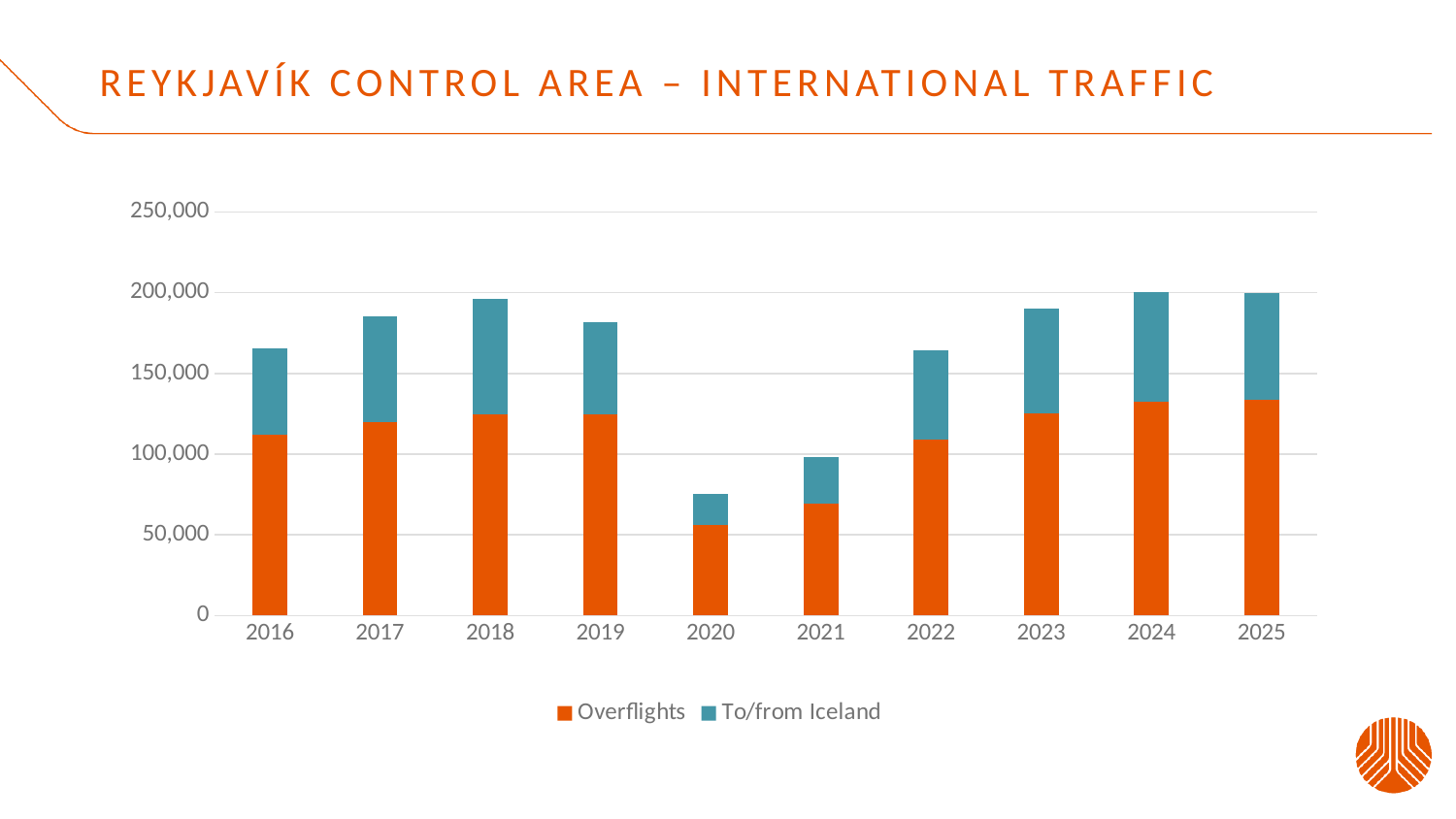
What kind of chart is shown on the slide? Stacked bar chart Is the total traffic for 2020 greater or less than 100,000? less How many years are shown on the x axis of the chart? 10 How many series does the legend list? 2 Which year has the larger total traffic, 2022 or 2023? 2023 Which year has the lowest Overflights value? 2020 Which series is shown in orange in the chart? Overflights Which year has the larger total traffic, 2018 or 2019? 2018 Which year has the lowest total international traffic? 2020 Is the Overflights value for 2024 greater or less than 100,000? greater Is the total traffic for 2018 greater or less than 150,000? greater Does total traffic rise or fall from 2021 to 2024? rise